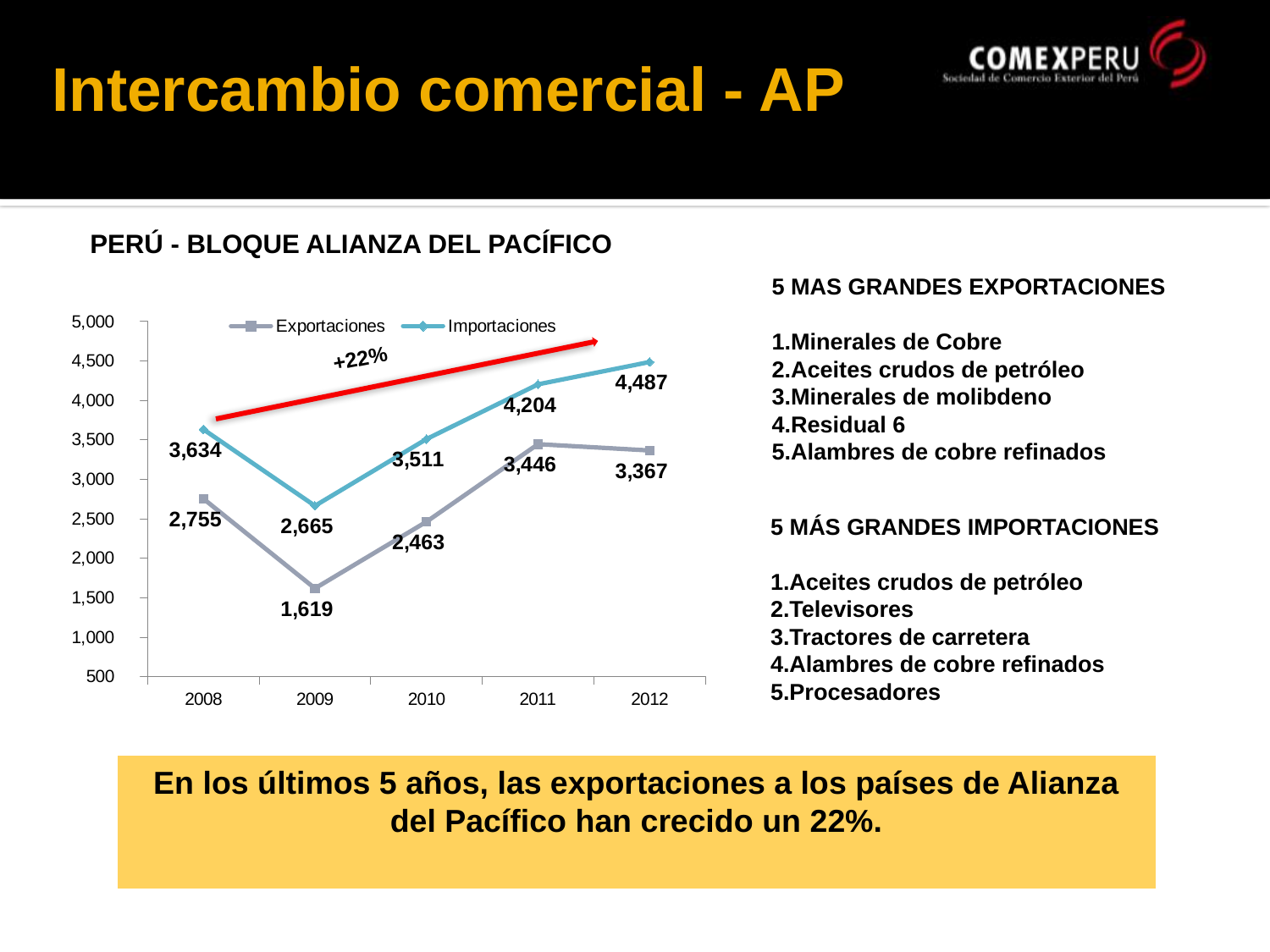
In which year is Importaciones highest? 2012 What is the value of Exportaciones in 2009? 1,619 How many series does the chart legend list? 2 How many years are plotted on the x axis? 5 What is the value of Exportaciones in 2011? 3,446 Which is larger in 2010, Exportaciones or Importaciones? Importaciones Does Importaciones rise or fall from 2009 to 2012? Rise What is the value of Importaciones in 2012? 4,487 In which year is Exportaciones lowest? 2009 What is the difference between Importaciones and Exportaciones in 2012? 1,120 What type of chart is shown on the slide? Line chart What is the title of the chart? PERÚ - BLOQUE ALIANZA DEL PACÍFICO